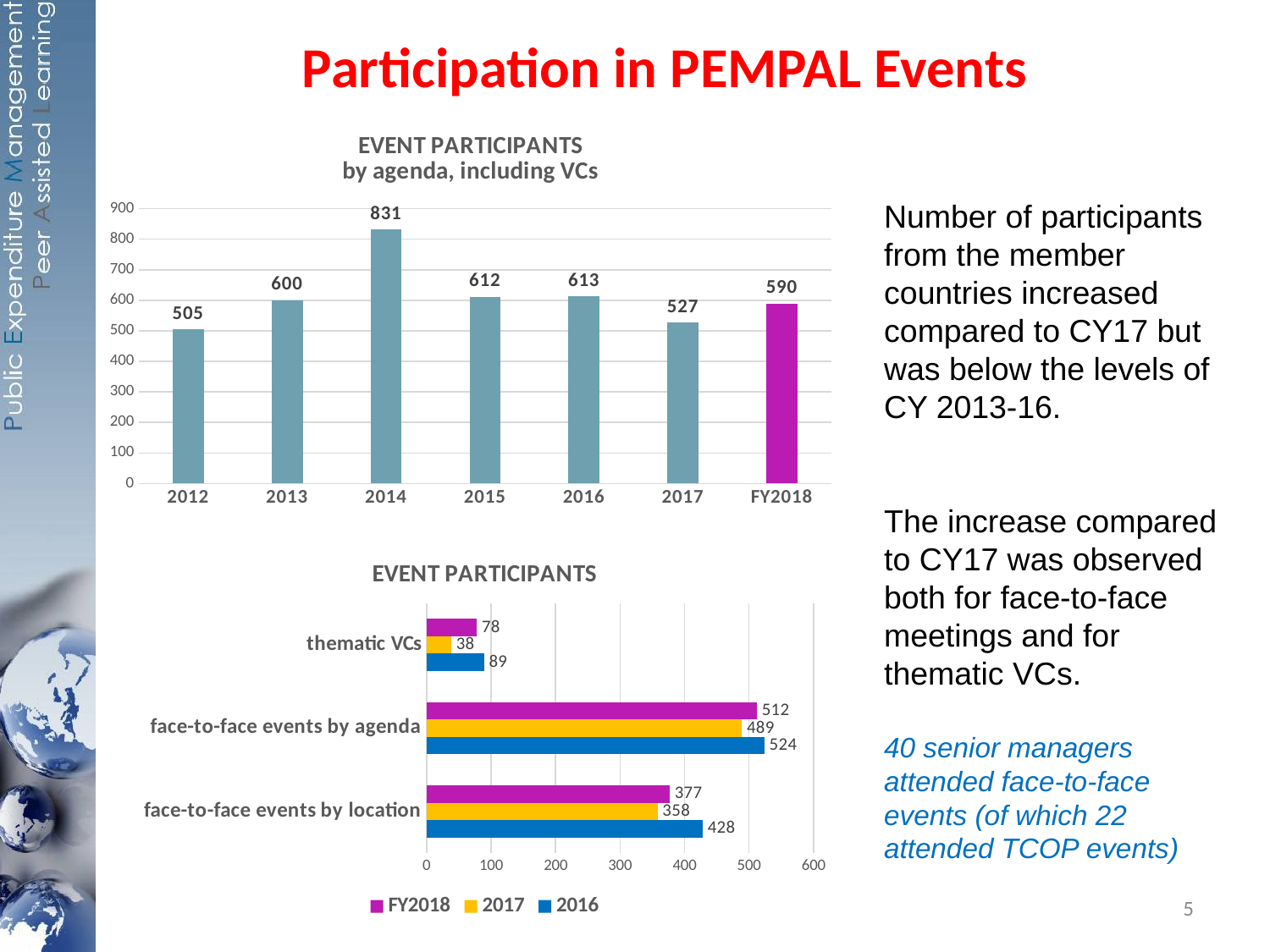
In the bottom chart 'EVENT PARTICIPANTS', how many series does the legend list? 3 In the top chart 'EVENT PARTICIPANTS by agenda, including VCs', what is the difference between the values for 2014 and 2017? 304 In the bottom chart 'EVENT PARTICIPANTS', what is the FY2018 value for thematic VCs? 78 In the top chart 'EVENT PARTICIPANTS by agenda, including VCs', which year has the lowest value? 2012 In the top chart 'EVENT PARTICIPANTS by agenda, including VCs', what is the value for 2014? 831 In the bottom chart 'EVENT PARTICIPANTS', which is larger for face-to-face events by location: the 2016 value or the FY2018 value? 2016 What kind of chart is the bottom chart 'EVENT PARTICIPANTS'? bar chart In the top chart 'EVENT PARTICIPANTS by agenda, including VCs', is the value for 2017 greater or less than 600? less In the bottom chart 'EVENT PARTICIPANTS', what is the 2017 value for face-to-face events by agenda? 489 In the top chart 'EVENT PARTICIPANTS by agenda, including VCs', what is the value for FY2018? 590 In the top chart 'EVENT PARTICIPANTS by agenda, including VCs', how many years are shown on the x axis? 7 In the top chart 'EVENT PARTICIPANTS by agenda, including VCs', which year has the highest value? 2014